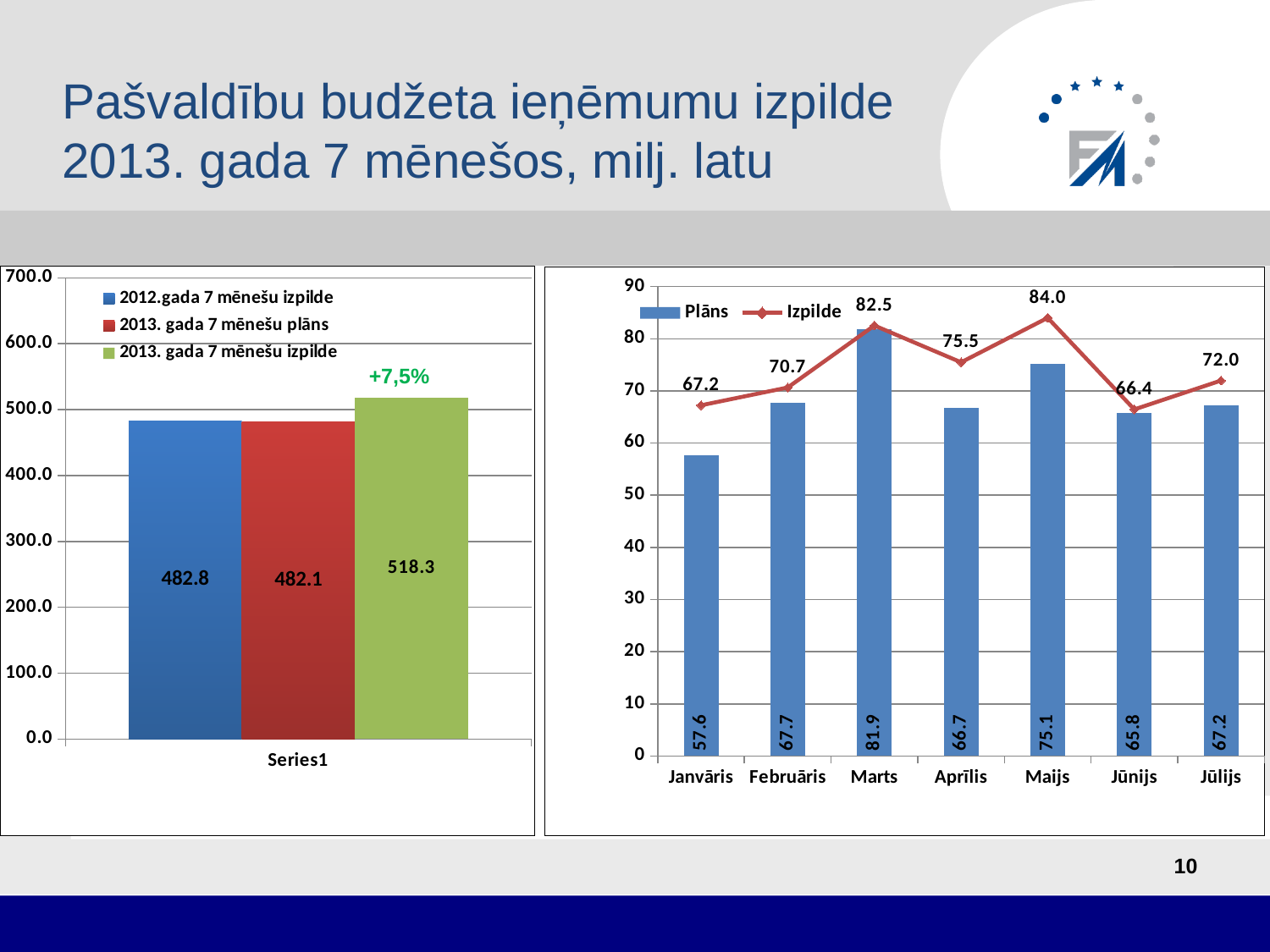
In the right chart, which month has the lowest Plāns value? Janvāris In the right chart, how many months are shown on the x axis? 7 In the right chart, what is the Izpilde value for Maijs? 84.0 In the right chart, is the Plāns value for Jūnijs greater or less than the Izpilde value for Jūnijs? less In the left chart, what is the difference between 2013. gada 7 mēnešu izpilde and 2013. gada 7 mēnešu plāns? 36.2 In the right chart, which month has the highest Izpilde value? Maijs In the left chart, what is the value for 2012.gada 7 mēnešu izpilde? 482.8 In the left chart, what is the value for 2013. gada 7 mēnešu izpilde? 518.3 In the right chart, what is the difference between Izpilde and Plāns for Aprīlis? 8.8 In the right chart, what is the Plāns value for Marts? 81.9 In the left chart, how many series does the legend list? 3 In the left chart, what percentage change is annotated above the green bar? +7,5%